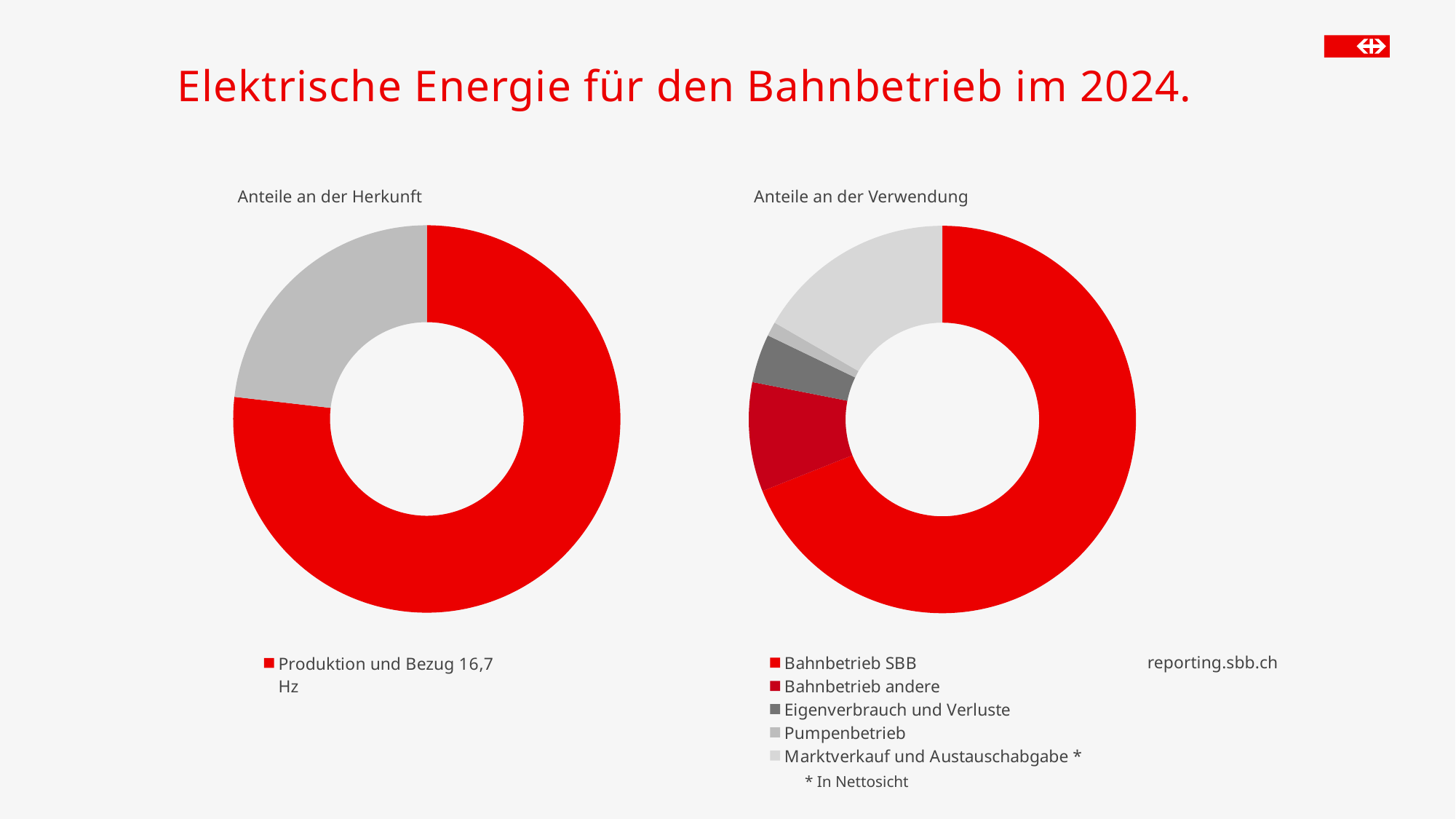
In the 'Anteile an der Herkunft' chart, which legend category has the largest share? Produktion und Bezug 16,7 Hz What kind of chart is the 'Anteile an der Herkunft' chart? Pie chart (donut) In the 'Anteile an der Verwendung' chart, which category has the largest share? Bahnbetrieb SBB What is the title of the slide? Elektrische Energie für den Bahnbetrieb im 2024. In the 'Anteile an der Verwendung' chart, how many slices does the donut have? 5 In the 'Anteile an der Verwendung' chart, which is larger: Marktverkauf und Austauschabgabe or Eigenverbrauch und Verluste? Marktverkauf und Austauschabgabe In the 'Anteile an der Verwendung' chart, which is larger: Bahnbetrieb andere or Eigenverbrauch und Verluste? Bahnbetrieb andere In the 'Anteile an der Herkunft' chart, how many entries does the legend list? 1 In the 'Anteile an der Verwendung' chart, how many entries does the legend list? 5 What kind of chart is the 'Anteile an der Verwendung' chart? Pie chart (donut) In the 'Anteile an der Verwendung' chart, what colour is the Bahnbetrieb SBB slice? Red In the 'Anteile an der Verwendung' chart, which category has the smallest share? Pumpenbetrieb